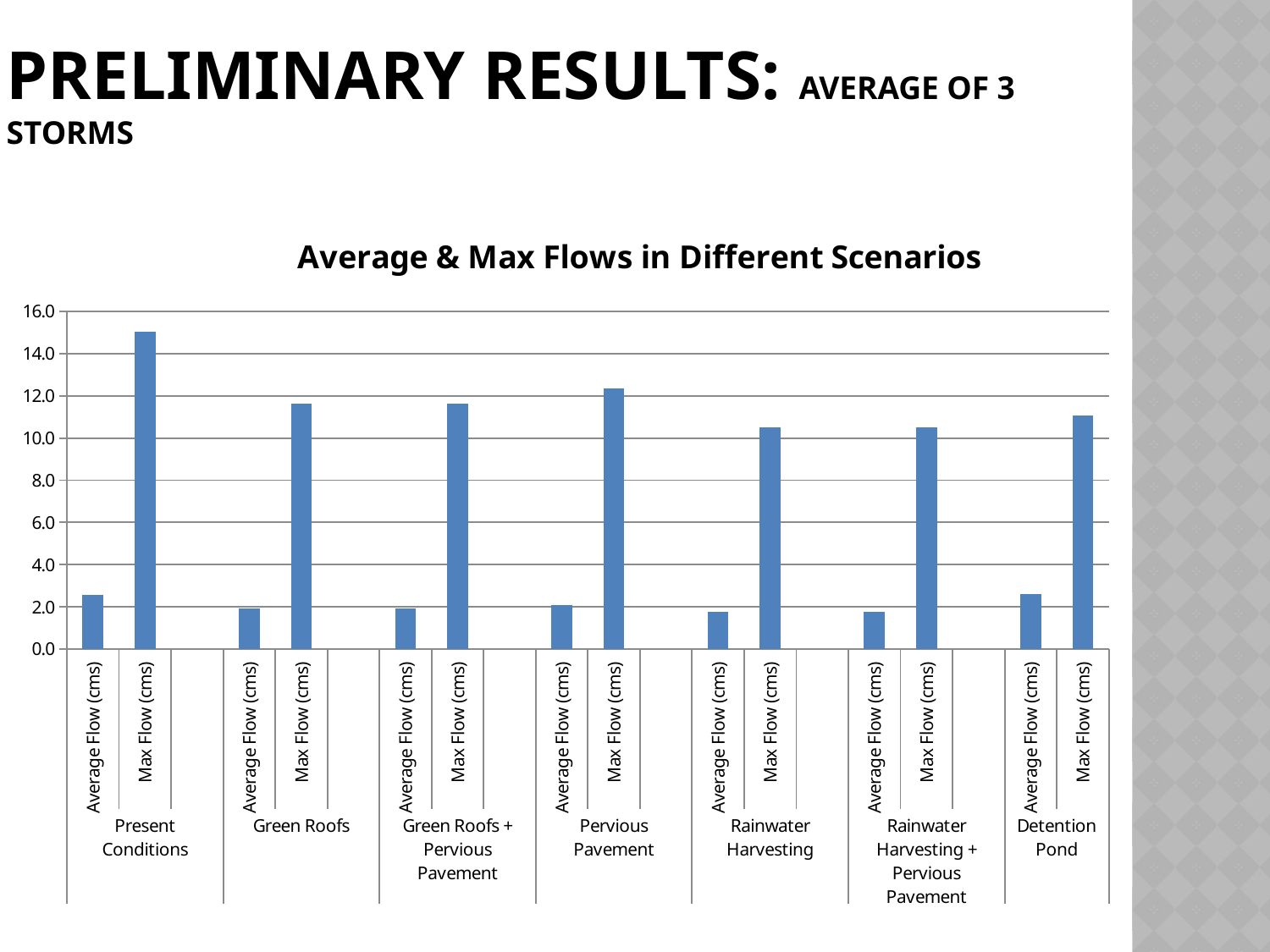
Is the Max Flow (cms) for Detention Pond greater or less than 10.0? greater What kind of chart is shown on the slide? Bar chart Is the Average Flow (cms) for Present Conditions greater or less than 4.0? less Which is larger: the Max Flow (cms) for Pervious Pavement or the Max Flow (cms) for Rainwater Harvesting? Pervious Pavement Which scenario has the highest Max Flow (cms)? Present Conditions How many bars are plotted in the chart in total? 14 What is the title of the chart? Average & Max Flows in Different Scenarios Is the Max Flow (cms) for Rainwater Harvesting greater or less than 12.0? less Which is larger: the Max Flow (cms) for Present Conditions or the Max Flow (cms) for Pervious Pavement? Present Conditions How many scenarios are shown along the x axis of the chart? 7 What unit is used for the flow values in the chart's category labels? cms